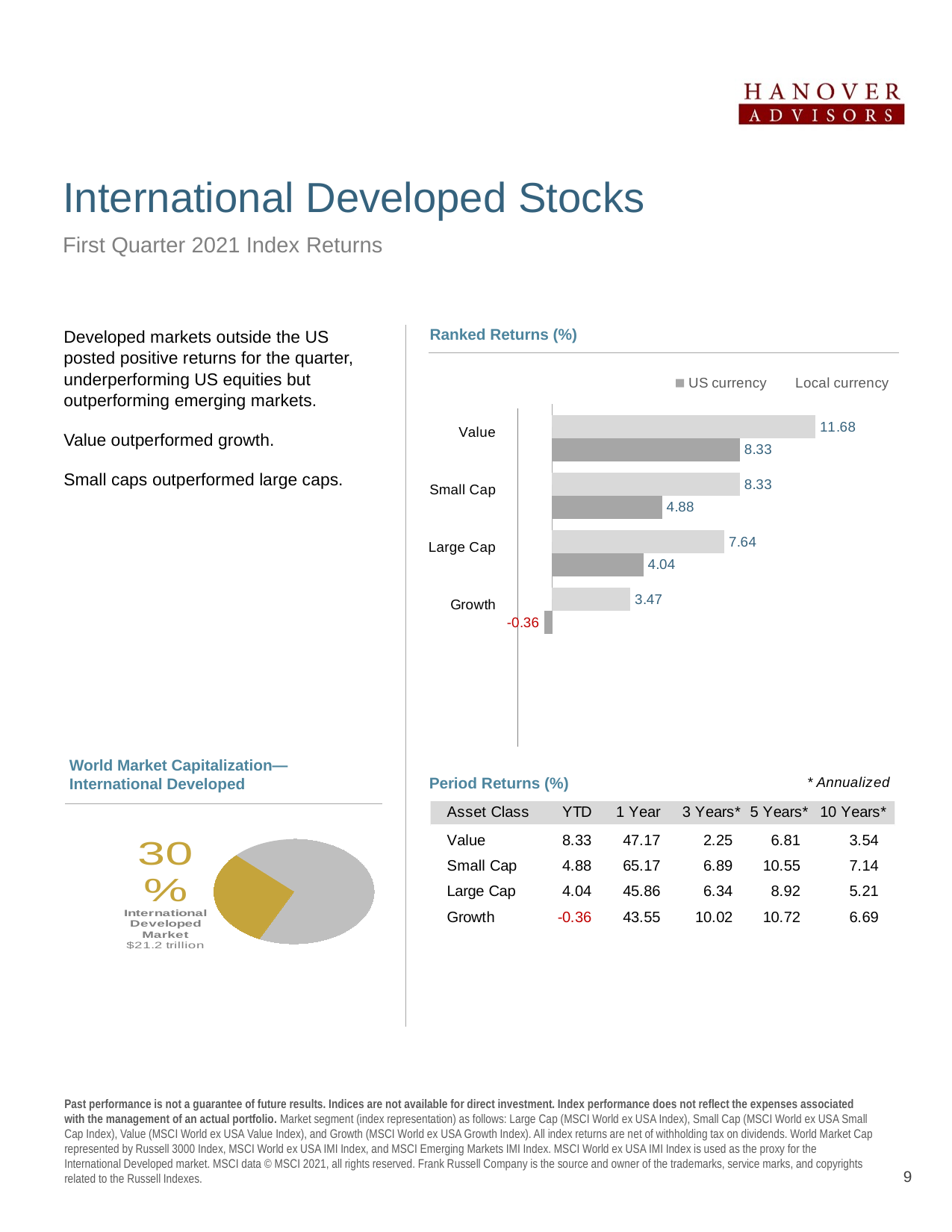
In the World Market Capitalization—International Developed chart, what share of world market capitalization does the International Developed Market represent? 30% What kind of chart is the World Market Capitalization—International Developed chart? Pie chart What kind of chart is the Ranked Returns (%) chart? Bar chart In the Ranked Returns (%) chart, which asset class has the lowest US currency return? Growth In the Ranked Returns (%) chart, what is the US currency return for Growth? -0.36 In the Ranked Returns (%) chart, which is larger: the US currency return for Small Cap or the US currency return for Large Cap? Small Cap In the Ranked Returns (%) chart, which asset class has the highest Local currency return? Value In the Ranked Returns (%) chart, what is the US currency return for Value? 8.33 In the Ranked Returns (%) chart, what is the difference between the Local currency and US currency returns for Large Cap? 3.60 How many asset classes are shown in the Ranked Returns (%) chart? 4 How many series does the legend of the Ranked Returns (%) chart list? 2 In the Ranked Returns (%) chart, what is the Local currency return for Small Cap? 8.33